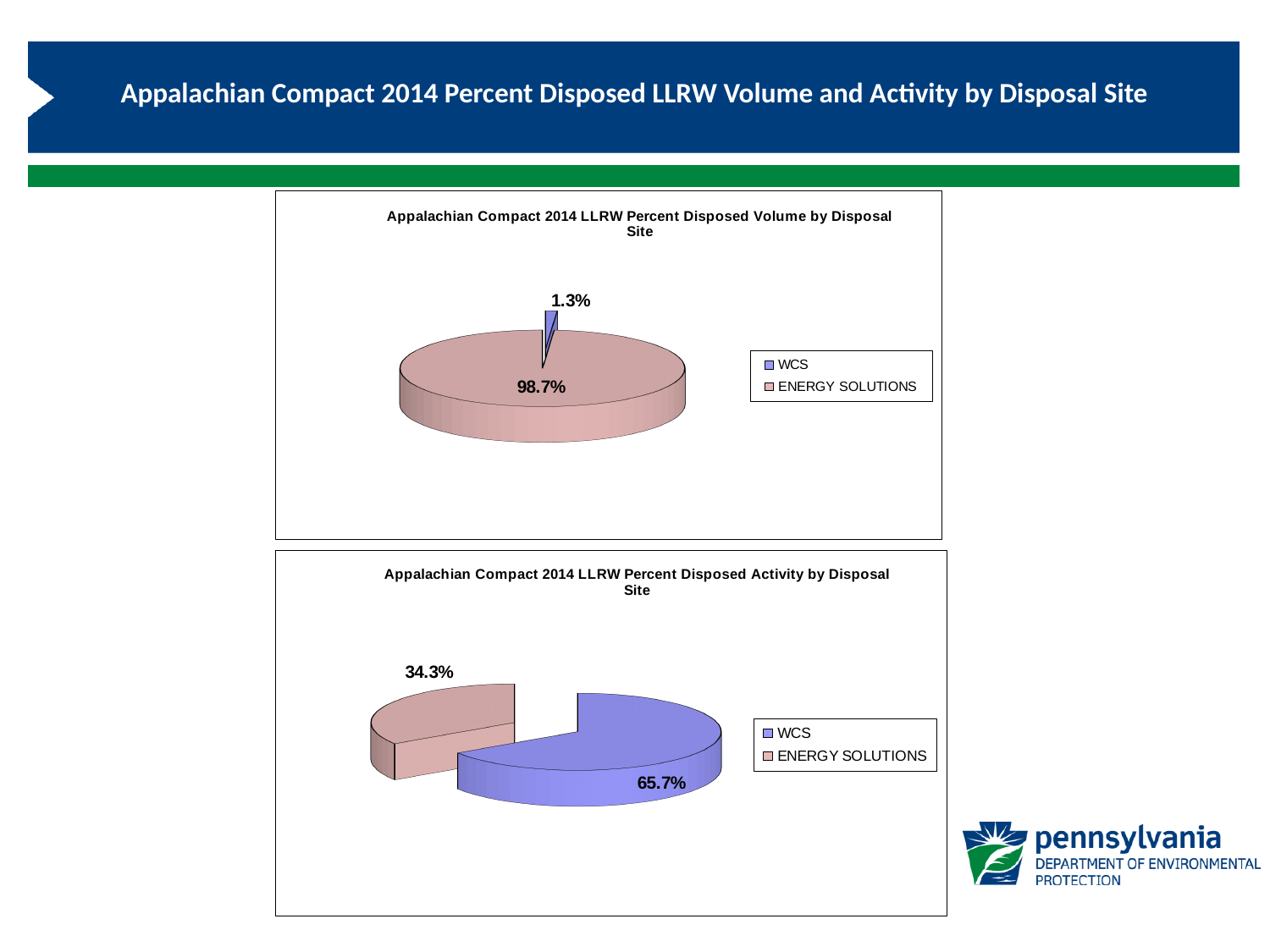
In the bottom chart (Percent Disposed Activity by Disposal Site), what is the difference between the WCS and ENERGY SOLUTIONS shares? 31.4% In the top chart (Percent Disposed Volume by Disposal Site), what share of the pie is WCS? 1.3% In the bottom chart (Percent Disposed Activity by Disposal Site), what share of the pie is WCS? 65.7% How many entries does the legend of the top chart (Percent Disposed Volume by Disposal Site) list? 2 In the bottom chart (Percent Disposed Activity by Disposal Site), which disposal site has the smallest slice? ENERGY SOLUTIONS In the bottom chart (Percent Disposed Activity by Disposal Site), what share of the pie is ENERGY SOLUTIONS? 34.3% In the top chart (Percent Disposed Volume by Disposal Site), which disposal site has the largest slice? ENERGY SOLUTIONS What kind of chart is the top chart (Percent Disposed Volume by Disposal Site)? Pie chart How many slices does the bottom chart (Percent Disposed Activity by Disposal Site) have? 2 In the bottom chart (Percent Disposed Activity by Disposal Site), which is larger, WCS or ENERGY SOLUTIONS? WCS In the top chart (Percent Disposed Volume by Disposal Site), what is the difference between the ENERGY SOLUTIONS and WCS shares? 97.4%